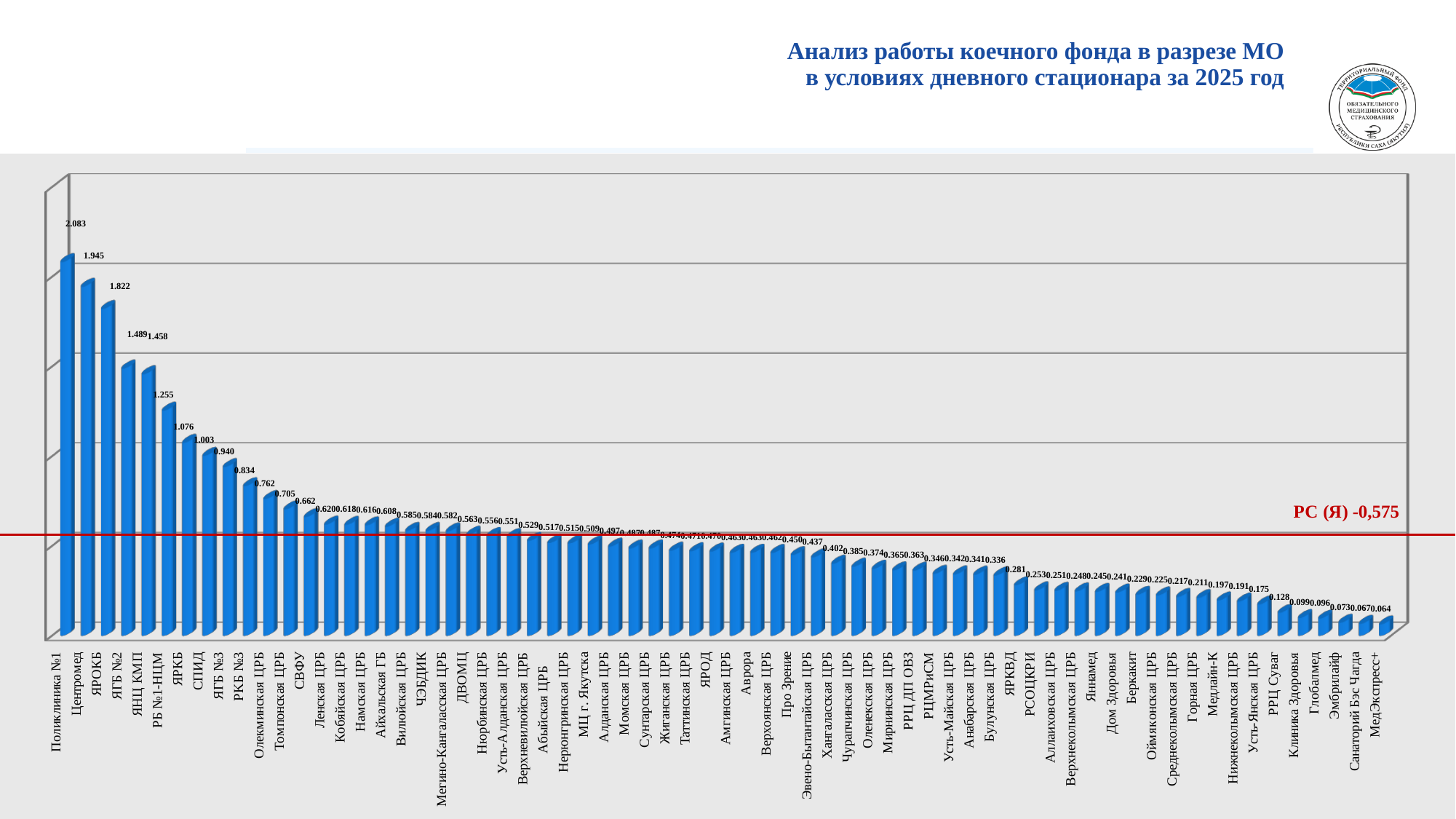
Do the values rise or fall from left to right along the x axis? fall Which is larger, the value for ЯГБ №2 or the value for ЯНЦ КМП? ЯГБ №2 What is the value for СПИД? 1.003 What type of chart is shown on the slide? bar chart Which category has the lowest value? МедЭкспресс+ What is the value for ЯРОКБ? 1.822 What is the value for Олекминская ЦРБ? 0.762 What is the value for Поликлиника №1? 2.083 What is the difference between the values for Поликлиника №1 and Центромед? 0.138 What value is shown for the reference line labelled РС (Я)? 0,575 Which category has the highest value? Поликлиника №1 What is the value for МедЭкспресс+? 0.064